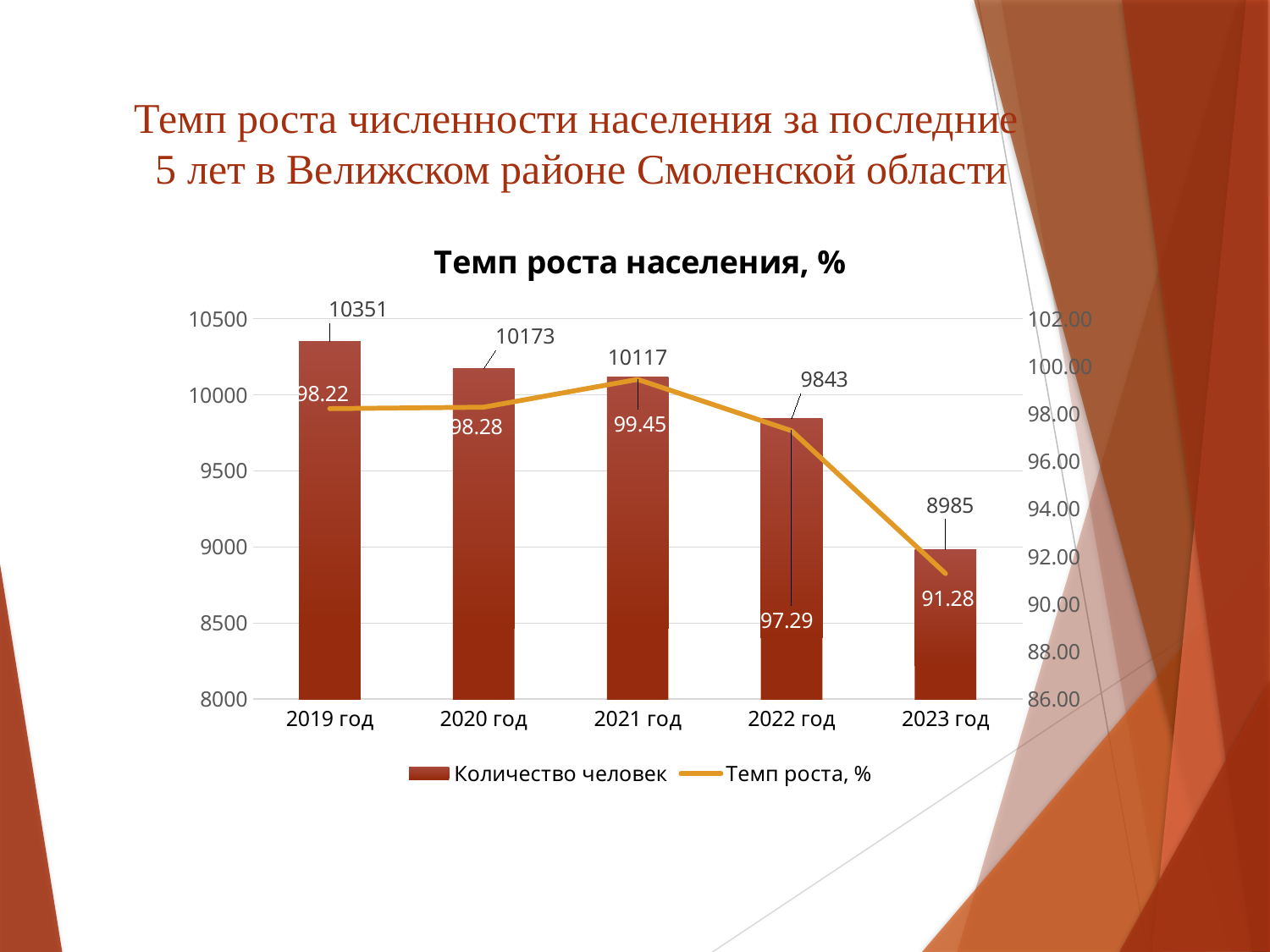
What is the value of Темп роста, % for 2021 год? 99.45 Which year has the highest Темп роста, %? 2021 год Does Количество человек rise or fall from 2019 год to 2023 год? fall How many series does the legend list? 2 What is the value of Темп роста, % for 2023 год? 91.28 What is the value of Количество человек for 2019 год? 10351 What kind of chart is this? Combined bar and line chart How many years are shown on the x axis? 5 Is the value of Количество человек for 2022 год greater or less than 10000? less Which year has the lowest Количество человек? 2023 год Which is larger, Количество человек for 2020 год or for 2021 год? 2020 год What is the difference in Количество человек between 2019 год and 2023 год? 1366